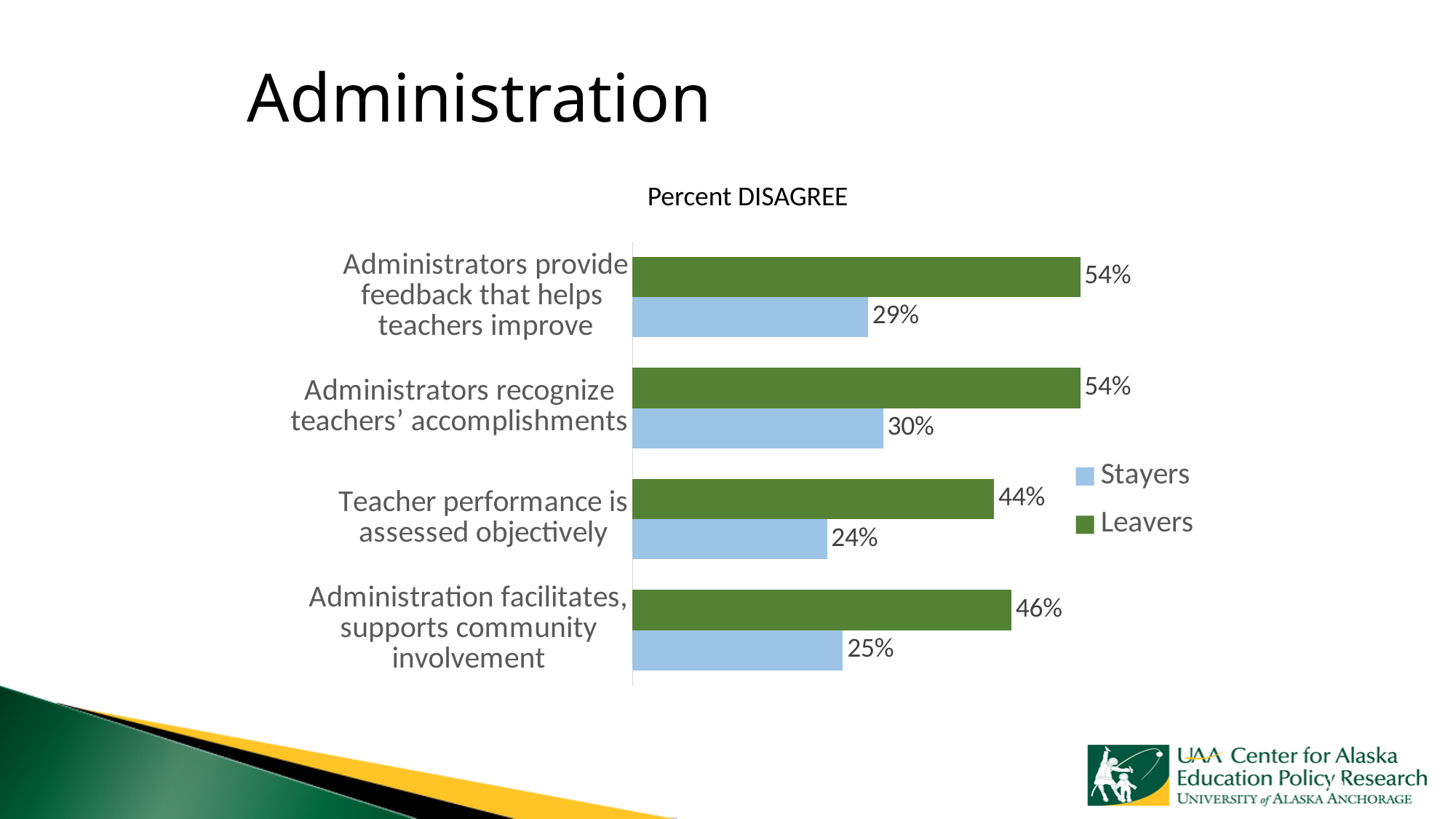
What percent of Stayers disagree that administration facilitates, supports community involvement? 25% Which statement has the lowest Leavers disagreement percentage? Teacher performance is assessed objectively What percent of Stayers disagree that teacher performance is assessed objectively? 24% Which statement has the highest Stayers disagreement percentage? Administrators recognize teachers' accomplishments What is the title of the chart? Percent DISAGREE How many series does the legend list? 2 What percent of Leavers disagree that teacher performance is assessed objectively? 44% What percent of Leavers disagree that administrators provide feedback that helps teachers improve? 54% What type of chart is shown on the slide? Bar chart What is the difference between the Leavers and Stayers percentages for 'Administrators recognize teachers' accomplishments'? 24 percentage points For 'Administration facilitates, supports community involvement', which group has the higher disagreement percentage, Stayers or Leavers? Leavers How many statements (categories) are shown in the chart? 4